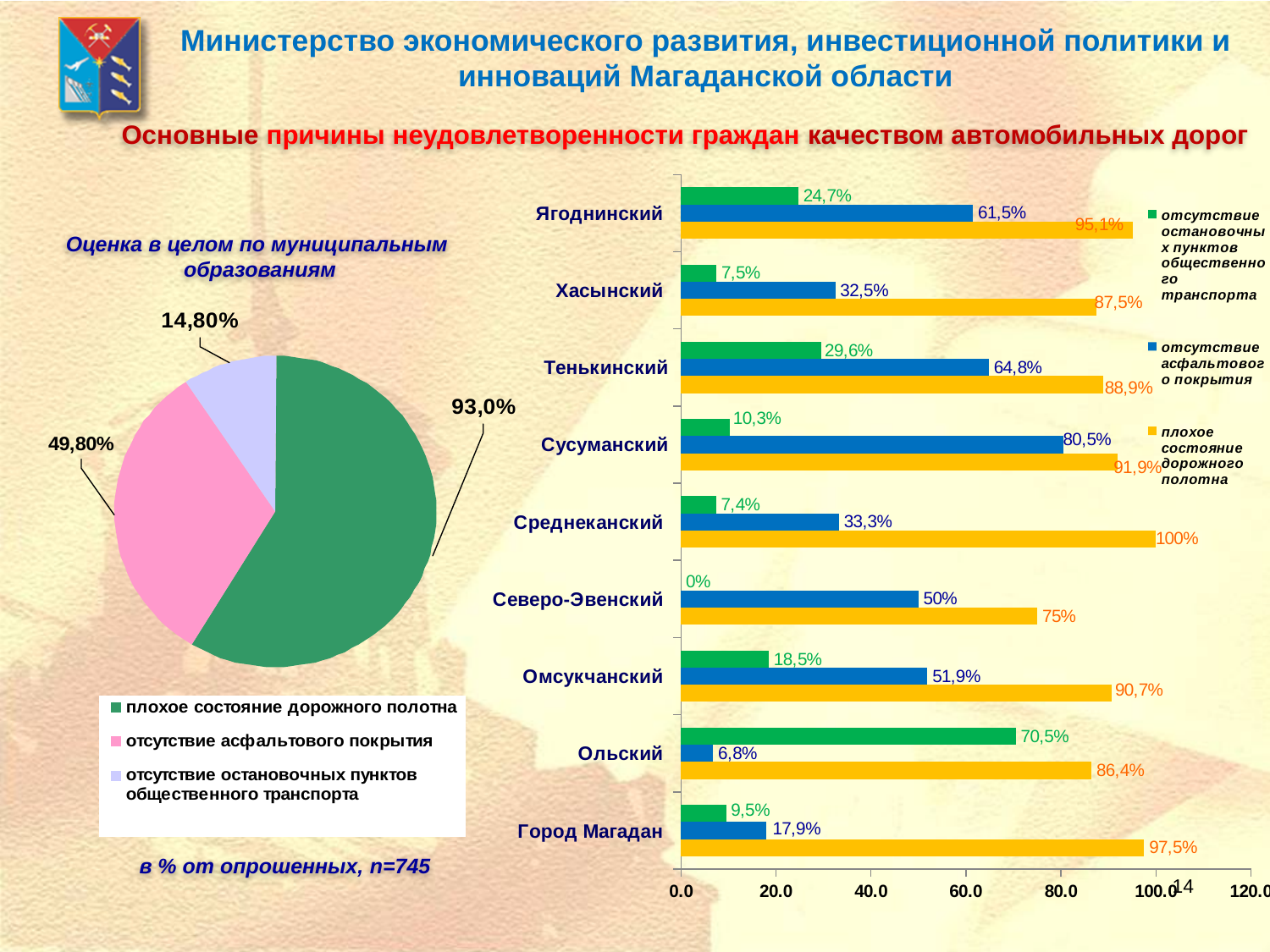
In the bar chart on the right, what is the value for "отсутствие асфальтового покрытия" in Сусуманский? 80,5% In the pie chart on the left, which category has the smallest value? отсутствие остановочных пунктов общественного транспорта In the bar chart on the right, which is larger: the "отсутствие асфальтового покрытия" value for Теньскинский or for Омсукчанский? Теньскинский In the bar chart on the right, what is the difference between the "плохое состояние дорожного полотна" values for Ягоднинский and Хасынский? 7,6% In the bar chart on the right, which municipality has the highest value for "отсутствие остановочных пунктов общественного транспорта"? Ольский In the bar chart on the right, what is the value for "отсутствие остановочных пунктов общественного транспорта" in Ольский? 70,5% In the bar chart on the right, what is the value for "плохое состояние дорожного полотна" in Среднеканский? 100% In the pie chart on the left, what is the value for "отсутствие остановочных пунктов общественного транспорта"? 14,80% In the pie chart on the left, what is the value for "плохое состояние дорожного полотна"? 93,0% In the pie chart on the left, how many categories does the legend list? 3 In the bar chart on the right, which municipality has the lowest value for "плохое состояние дорожного полотна"? Северо-Эвенский In the bar chart on the right, how many municipalities are shown? 9